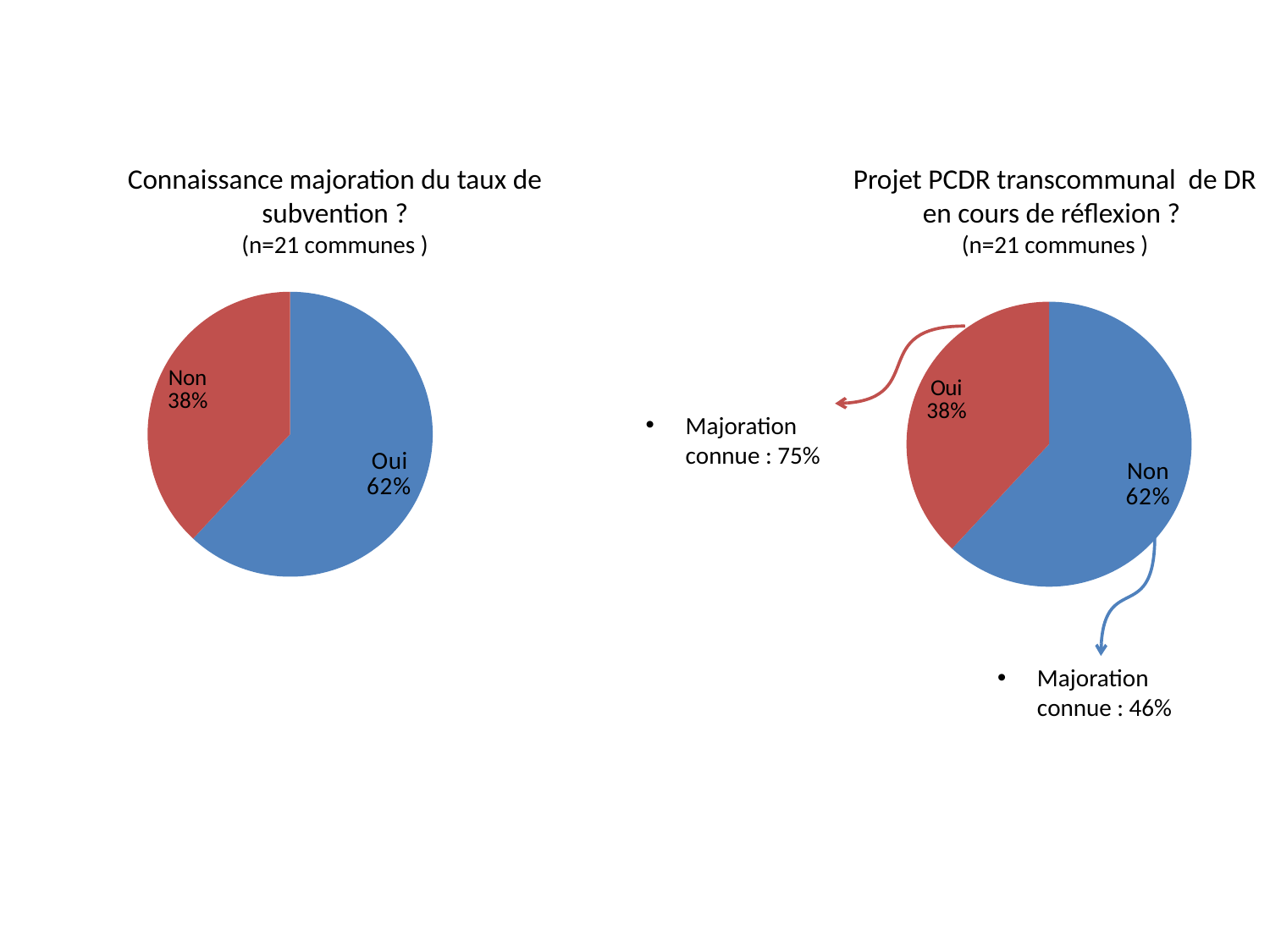
How many communes does the left chart 'Connaissance majoration du taux de subvention ?' state as its sample size? n=21 communes In the right chart 'Projet PCDR transcommunal de DR en cours de réflexion ?', what share of the pie is 'Non'? 62% In the right chart 'Projet PCDR transcommunal de DR en cours de réflexion ?', which is larger, 'Oui' or 'Non'? Non In the right chart 'Projet PCDR transcommunal de DR en cours de réflexion ?', which slice is the smallest? Oui In the left chart 'Connaissance majoration du taux de subvention ?', what is the difference in percentage points between 'Oui' and 'Non'? 24 In the left chart 'Connaissance majoration du taux de subvention ?', what share of the pie is 'Oui'? 62% In the left chart 'Connaissance majoration du taux de subvention ?', which slice is the largest? Oui In the right chart 'Projet PCDR transcommunal de DR en cours de réflexion ?', what share of the pie is 'Oui'? 38% How many slices does the left chart 'Connaissance majoration du taux de subvention ?' have? 2 What kind of chart is the right chart 'Projet PCDR transcommunal de DR en cours de réflexion ?'? Pie chart In the right chart 'Projet PCDR transcommunal de DR en cours de réflexion ?', what colour is the 'Non' slice? Blue